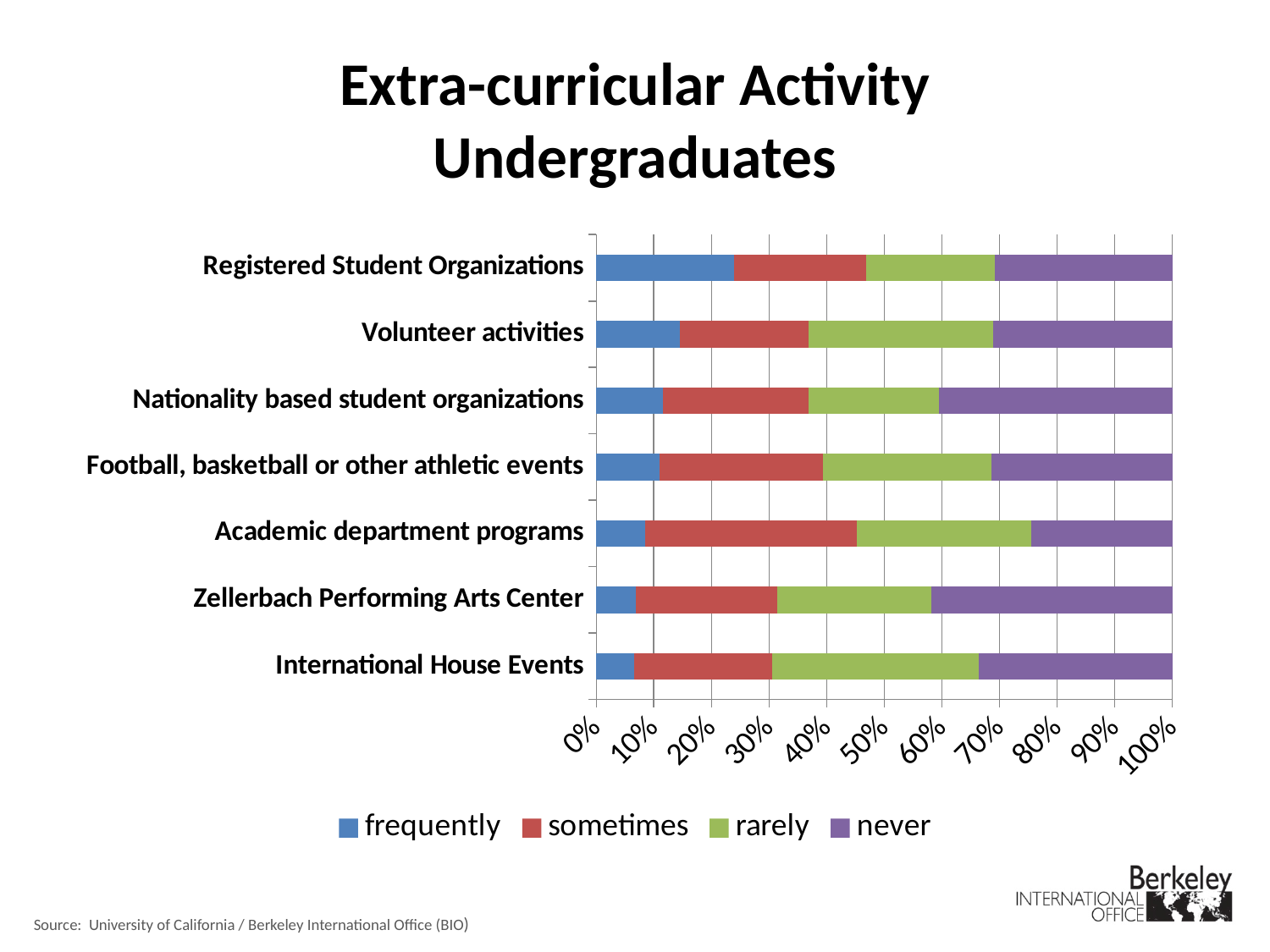
Is the 'frequently' value for Registered Student Organizations greater or less than 20%? greater Is the 'sometimes' value for Academic department programs greater or less than 30%? greater Which has a larger 'frequently' segment: Registered Student Organizations or Volunteer activities? Registered Student Organizations What kind of chart is shown on the slide? stacked bar chart Which category has the largest 'frequently' segment? Registered Student Organizations Which legend entry is shown in purple? never Is the 'frequently' value for International House Events greater or less than 10%? less Which category has the smallest 'never' segment? Academic department programs What is the title of the chart? Extra-curricular Activity Undergraduates How many series does the legend list? 4 Which has a larger 'never' segment: Zellerbach Performing Arts Center or Academic department programs? Zellerbach Performing Arts Center How many activity categories are plotted on the chart? 7